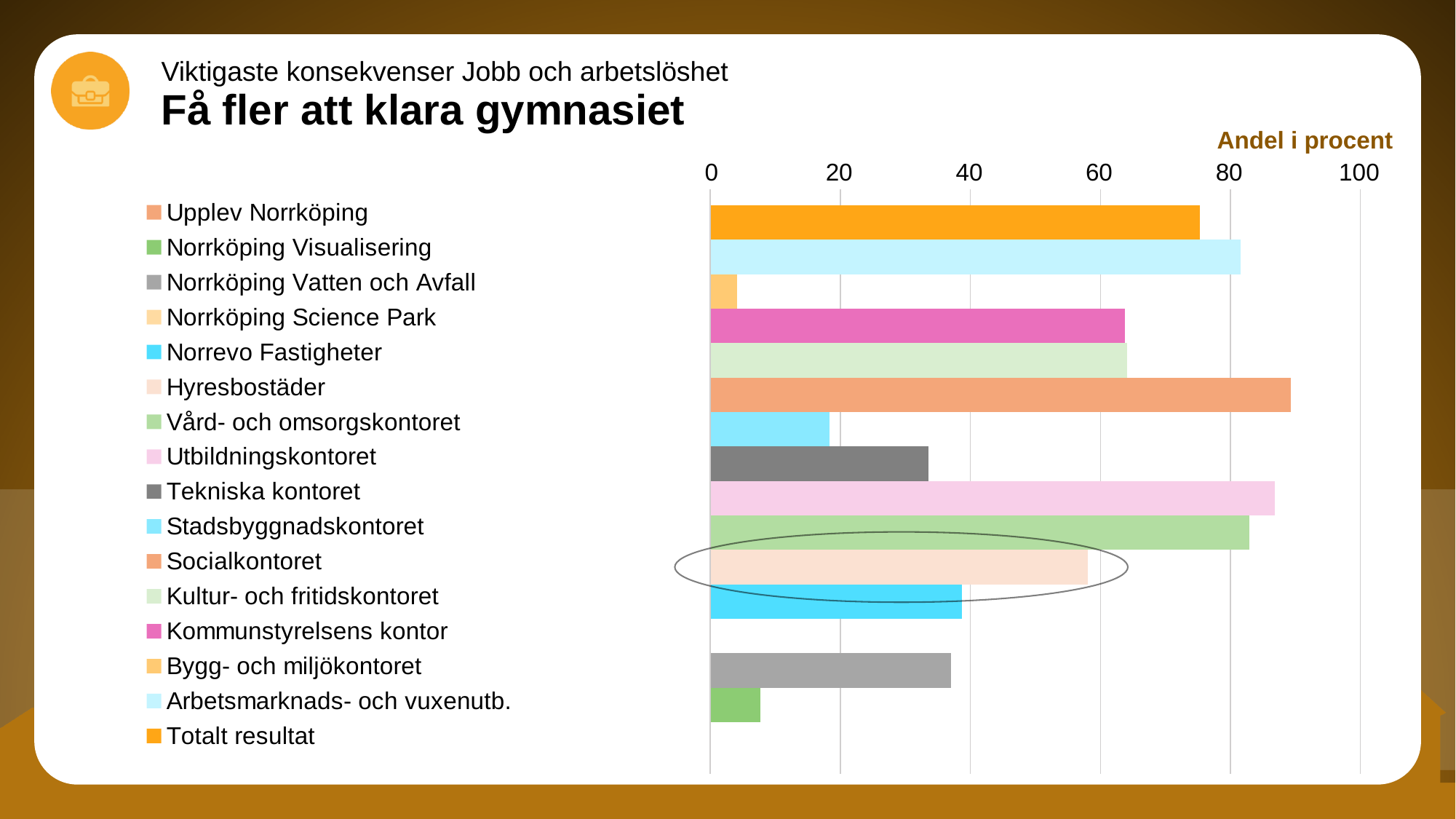
Is the value for Hyresbostäder greater or less than 40? greater What is the label shown above the horizontal axis of the chart? Andel i procent Is the value for Socialkontoret greater or less than 80? greater Which has the larger value, Utbildningskontoret or Tekniska kontoret? Utbildningskontoret Is the value for Stadsbyggnadskontoret greater or less than 40? less What kind of chart is shown on the slide? bar chart How many entries does the chart legend list? 16 Which has the larger value, Socialkontoret or Stadsbyggnadskontoret? Socialkontoret